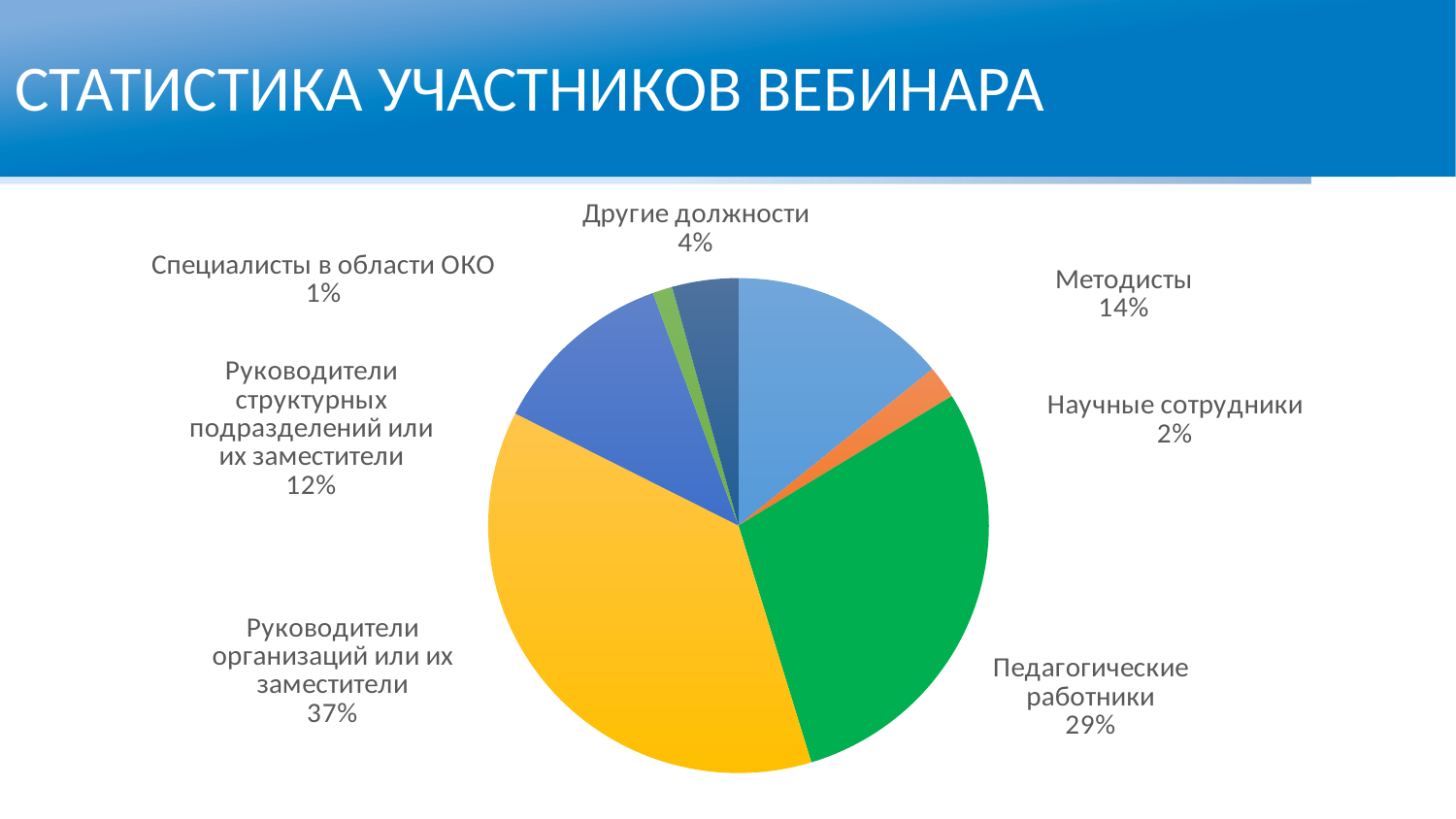
Which category has the largest share of participants? Руководители организаций или их заместители What share of webinar participants are Методисты? 14% What is the title of the slide containing the chart? СТАТИСТИКА УЧАСТНИКОВ ВЕБИНАРА Which category has the smallest share of participants? Специалисты в области ОКО What share of webinar participants are Специалисты в области ОКО? 1% What is the difference in percentage points between Руководители организаций или их заместители and Педагогические работники? 8 What share of webinar participants are Руководители организаций или их заместители? 37% What type of chart is shown on the slide? pie chart What is the combined share of Научные сотрудники and Другие должности? 6% Which is larger: the share of Методисты or the share of Руководители структурных подразделений или их заместители? Методисты How many categories are shown in the pie chart? 7 What share of webinar participants are Педагогические работники? 29%